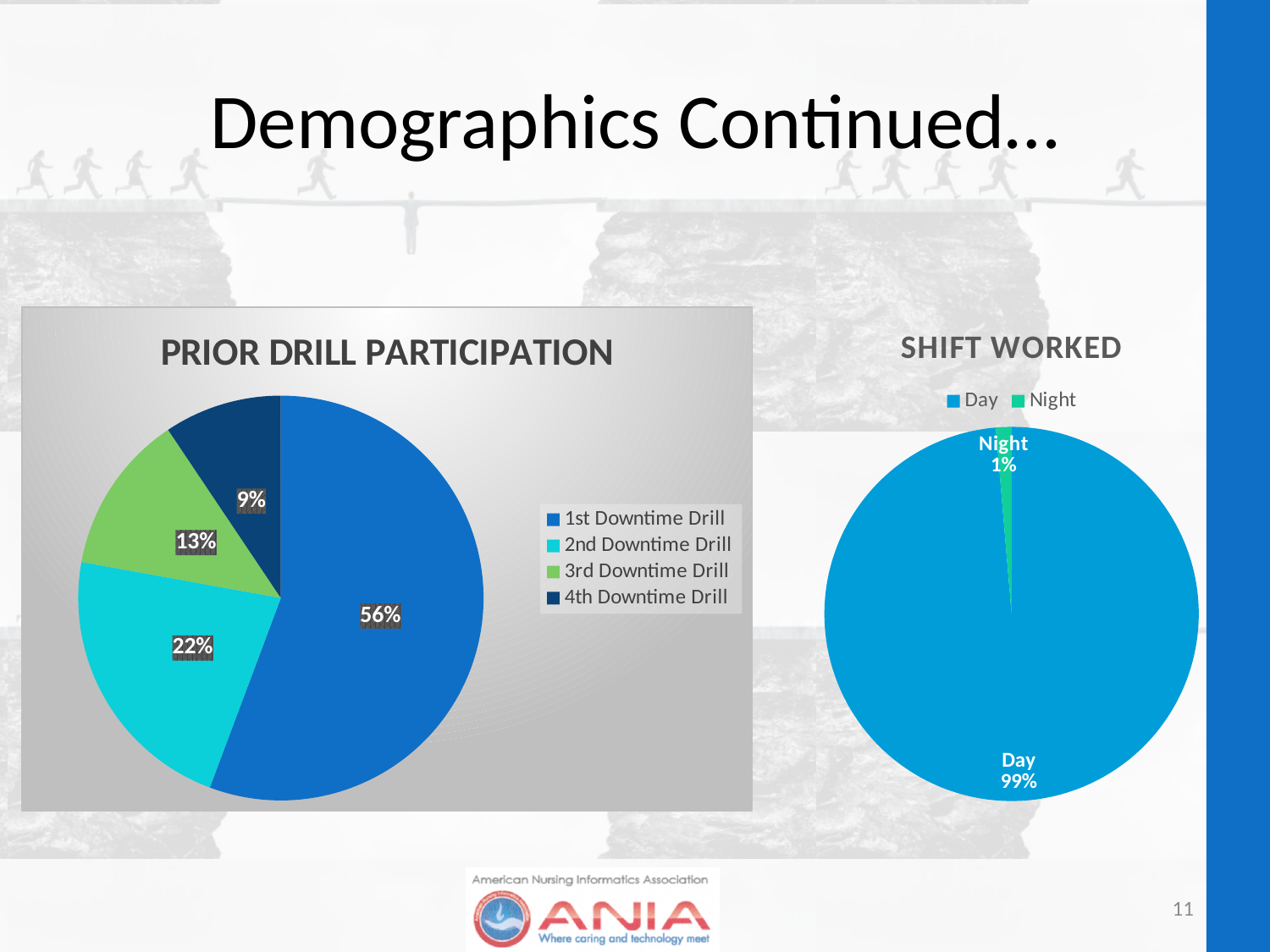
In the SHIFT WORKED chart, what share is shown for Day? 99% In the SHIFT WORKED chart, how many categories does the legend list? 2 In the PRIOR DRILL PARTICIPATION chart, which category has the largest slice? 1st Downtime Drill In the PRIOR DRILL PARTICIPATION chart, what share is shown for the 2nd Downtime Drill? 22% In the PRIOR DRILL PARTICIPATION chart, how many categories does the legend list? 4 In the SHIFT WORKED chart, what share is shown for Night? 1% In the PRIOR DRILL PARTICIPATION chart, what is the difference between the 2nd Downtime Drill and 3rd Downtime Drill shares? 9% In the PRIOR DRILL PARTICIPATION chart, which category has the smallest slice? 4th Downtime Drill In the SHIFT WORKED chart, which is larger, Day or Night? Day What kind of chart is the PRIOR DRILL PARTICIPATION chart? Pie chart